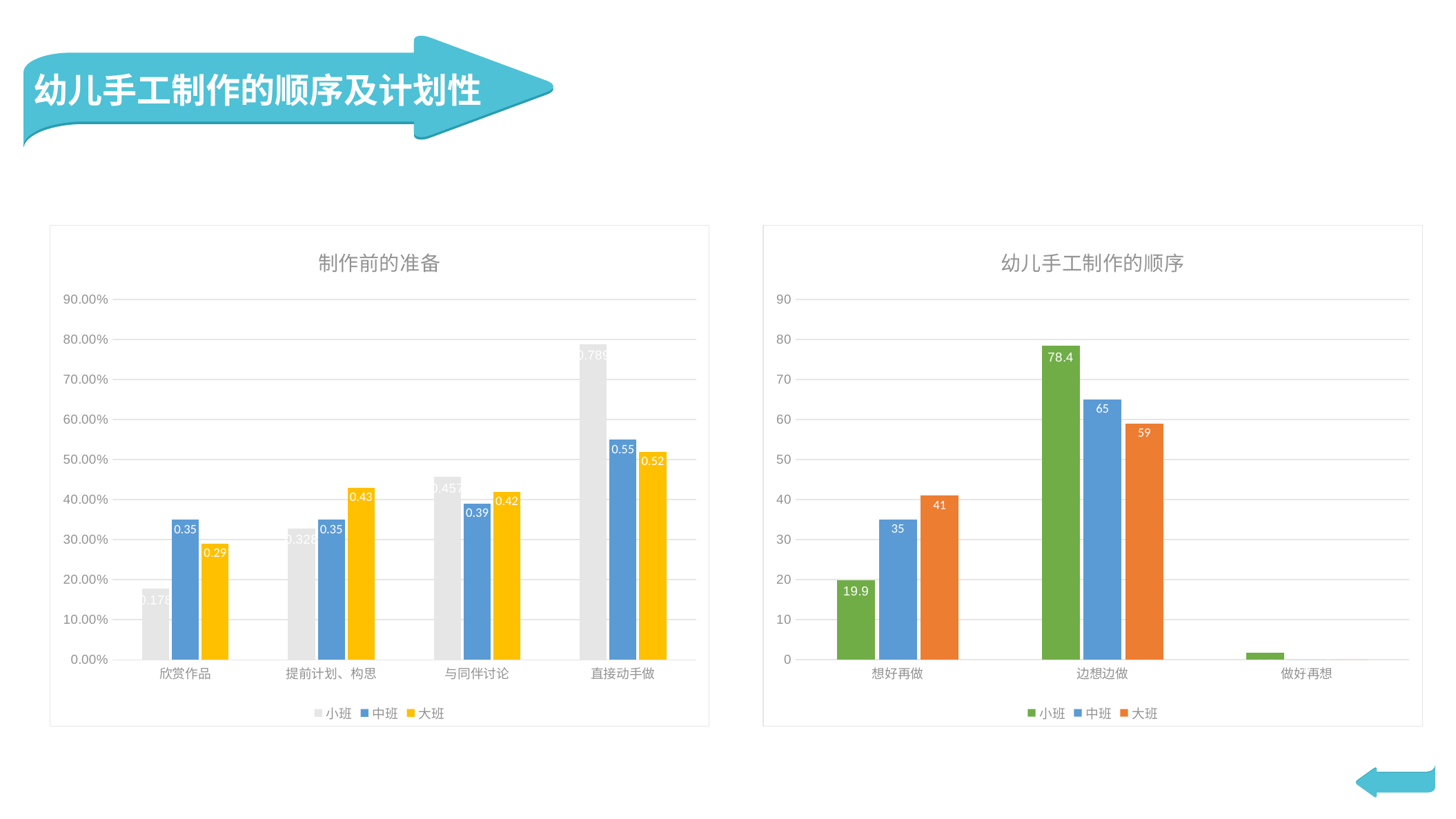
In the chart titled 制作前的准备, which is larger for 欣赏作品: the 中班 value or the 大班 value? 中班 In the chart titled 幼儿手工制作的顺序, which category has the lowest values across all series? 做好再想 In the chart titled 制作前的准备, what is the value for 中班 in the 直接动手做 category? 0.55 In the chart titled 幼儿手工制作的顺序, how many categories are shown on the x axis? 3 In the chart titled 幼儿手工制作的顺序, what is the value for 小班 in the 边想边做 category? 78.4 In the chart titled 制作前的准备, how many series does the legend list? 3 In the chart titled 制作前的准备, what is the value for 大班 in the 提前计划、构思 category? 0.43 In the chart titled 幼儿手工制作的顺序, is the 小班 value for 做好再想 greater or less than 10? less In the chart titled 制作前的准备, which category has the highest value for 大班? 直接动手做 In the chart titled 幼儿手工制作的顺序, what is the value for 大班 in the 想好再做 category? 41 In the chart titled 幼儿手工制作的顺序, what is the difference between the 中班 values for 边想边做 and 想好再做? 30 What type of chart is the chart titled 制作前的准备? bar chart